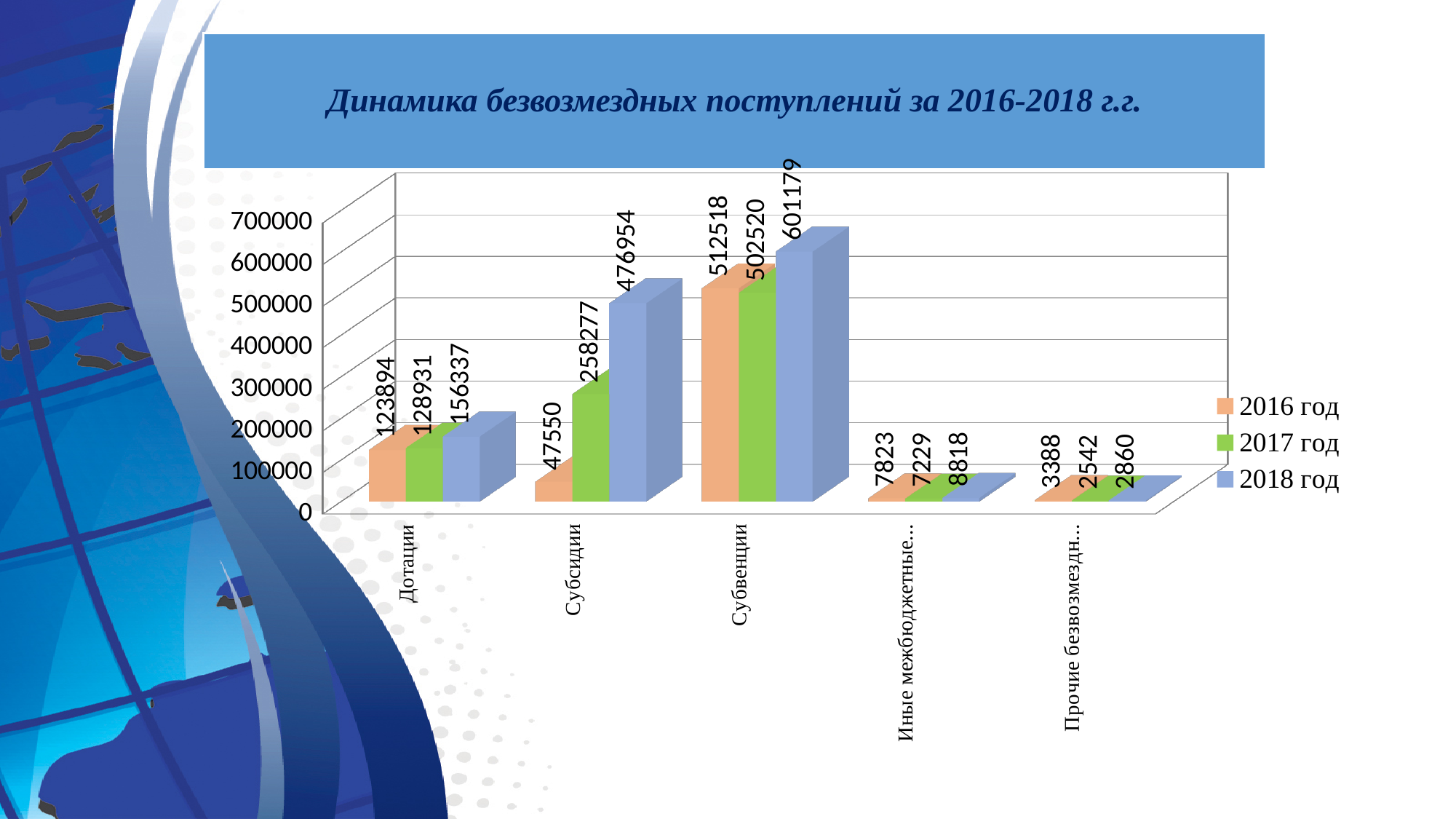
What is the value for Субвенции in 2017 год? 502520 What is the difference between the 2018 год and 2016 год values for Субсидии? 429404 How many categories are shown on the x axis? 5 Which category has the highest value in 2018 год? Субвенции Which is larger for Субвенции: the 2016 год value or the 2017 год value? 2016 год How many series does the legend list? 3 Is the value for Субвенции in 2018 год greater or less than 500000? greater What is the value for Субсидии in 2018 год? 476954 What is the value for Дотации in 2016 год? 123894 Which of the three labelled categories (Дотации, Субсидии, Субвенции) has the lowest value in 2016 год? Субсидии What type of chart is shown on the slide? bar chart What is the difference between the 2018 год and 2017 год values for Дотации? 27406